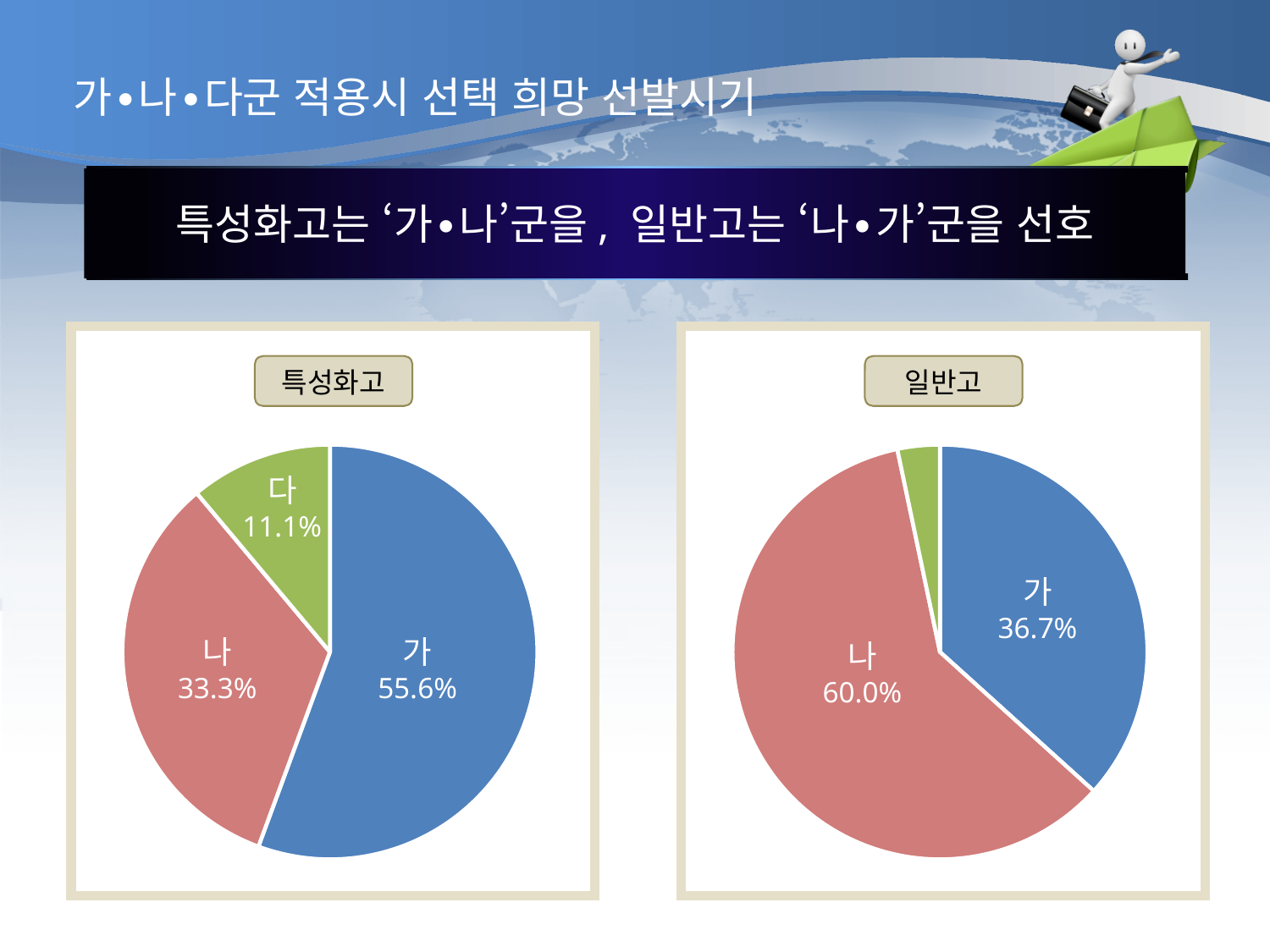
How many slices does the 특성화고 pie chart have? 3 In the 일반고 pie chart, which labelled category has the larger share, 가 or 나? 나 In the 일반고 pie chart, what is the share for 나? 60.0% In the 특성화고 pie chart, what is the share for 다? 11.1% In the 특성화고 pie chart, what is the difference between the shares of 가 and 나? 22.3% What type of chart is used for 일반고? Pie chart What colour is the 나 slice in the 특성화고 pie chart? Red In the 일반고 pie chart, what is the share for 가? 36.7% In the 특성화고 pie chart, which category has the largest share? 가 In the 특성화고 pie chart, which category has the smallest share? 다 In the 일반고 pie chart, what is the difference between the shares of 나 and 가? 23.3% In the 특성화고 pie chart, what is the share for 가? 55.6%